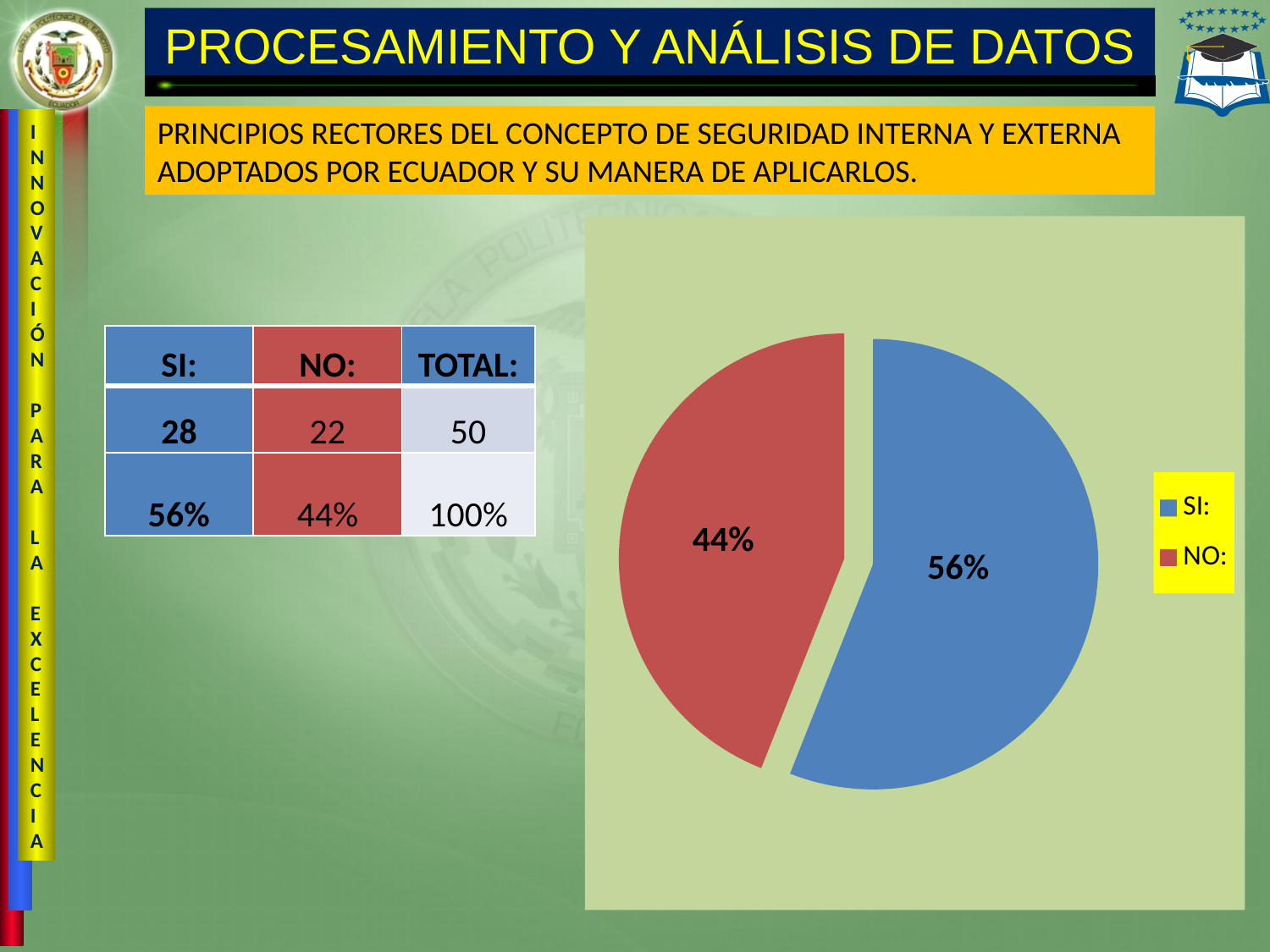
What colour is the NO: slice in the pie chart? red Which slice is larger, SI: or NO:? SI: How many slices does the pie chart have? 2 What colour is the SI: slice in the pie chart? blue What share of the pie does the SI: slice represent? 56% What share of the pie does the NO: slice represent? 44% Which slice of the pie is the smallest? NO: What kind of chart is shown on the slide? pie chart How many entries does the legend list? 2 Which slice of the pie is the largest? SI: What is the difference in percentage points between the SI: and NO: slices? 12%